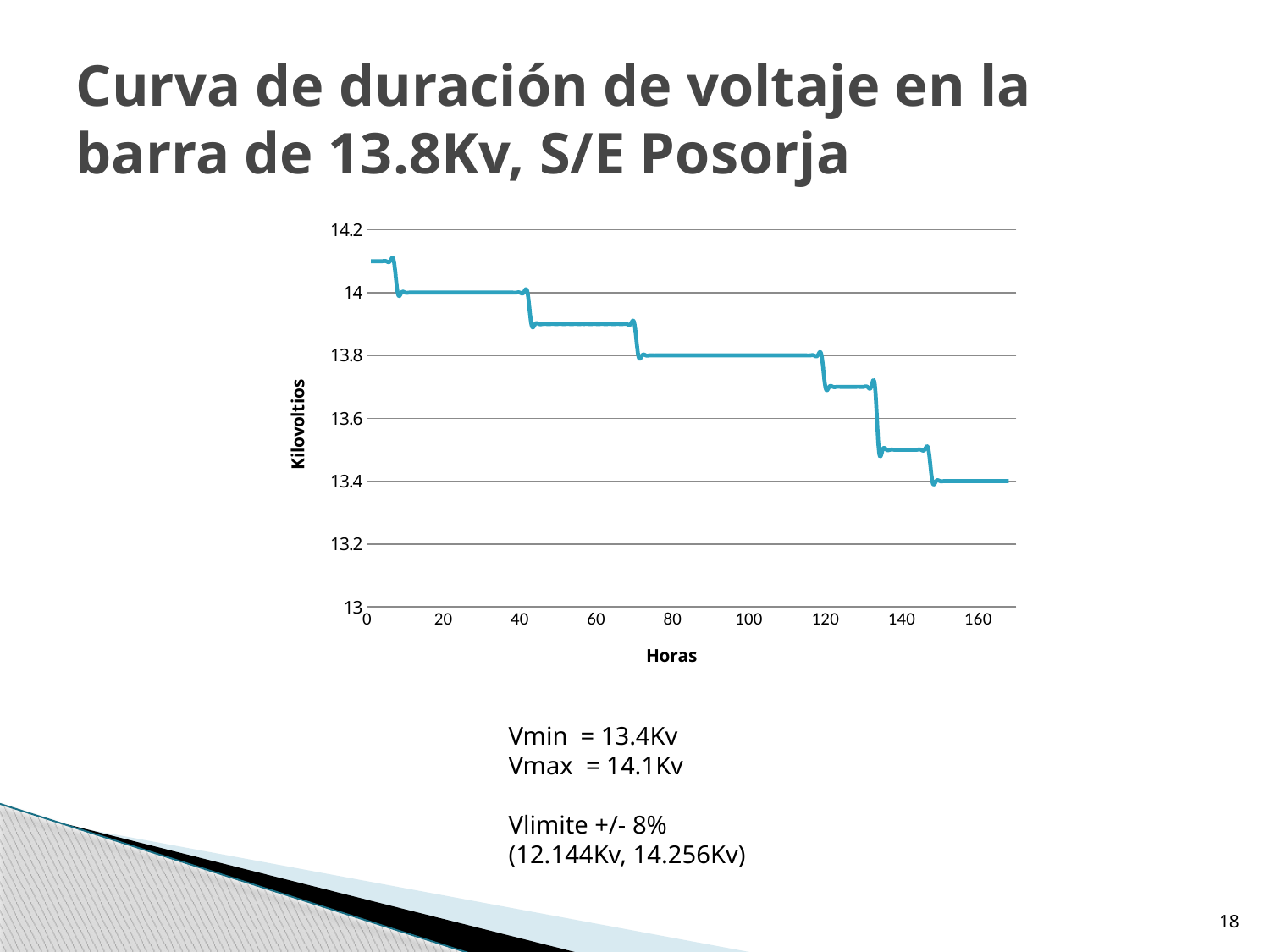
Is the voltage at 140 hours greater or less than 13.6? less What is the difference between Vmax and Vmin shown on the slide? 0.7Kv What kind of chart is shown on the slide? line chart What is the label of the vertical axis of the chart? Kilovoltios What voltage does the curve show at 160 hours? 13.4 Is the voltage at 60 hours greater or less than 14? less What is the title of the chart on the slide? Curva de duración de voltaje en la barra de 13.8Kv, S/E Posorja What is the maximum voltage (Vmax) shown on the slide? 14.1Kv Is the voltage at 20 hours greater or less than 13.8? greater What voltage does the curve show at 100 hours? 13.8 What is the minimum voltage (Vmin) shown on the slide? 13.4Kv Do the voltage values rise or fall as the hours increase along the x axis? fall